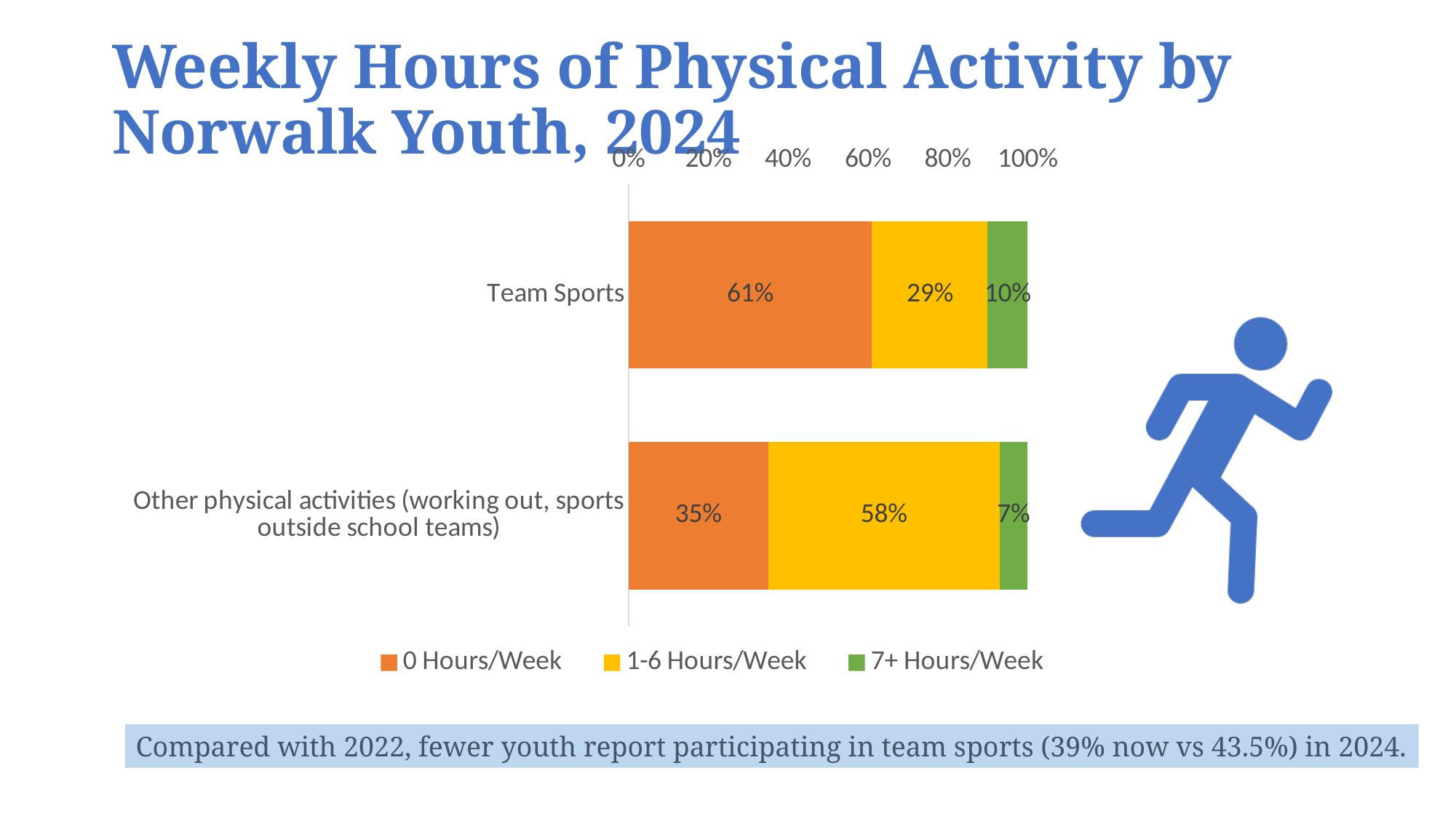
What kind of chart is shown on the slide? Stacked bar chart Which series has the smallest share for Other physical activities? 7+ Hours/Week What percentage of youth report 1-6 Hours/Week of Other physical activities (working out, sports outside school teams)? 58% What percentage of youth report 0 Hours/Week of Team Sports? 61% What percentage of youth report 7+ Hours/Week of Team Sports? 10% What is the difference between the 0 Hours/Week share for Team Sports and for Other physical activities? 26% How many categories are shown on the chart? 2 Which series has the largest share for Team Sports? 0 Hours/Week Which category has the higher 1-6 Hours/Week share, Team Sports or Other physical activities? Other physical activities (working out, sports outside school teams) How many series does the legend list? 3 What percentage of youth report 0 Hours/Week of Other physical activities (working out, sports outside school teams)? 35% What is the difference between the 7+ Hours/Week share for Team Sports and for Other physical activities? 3%